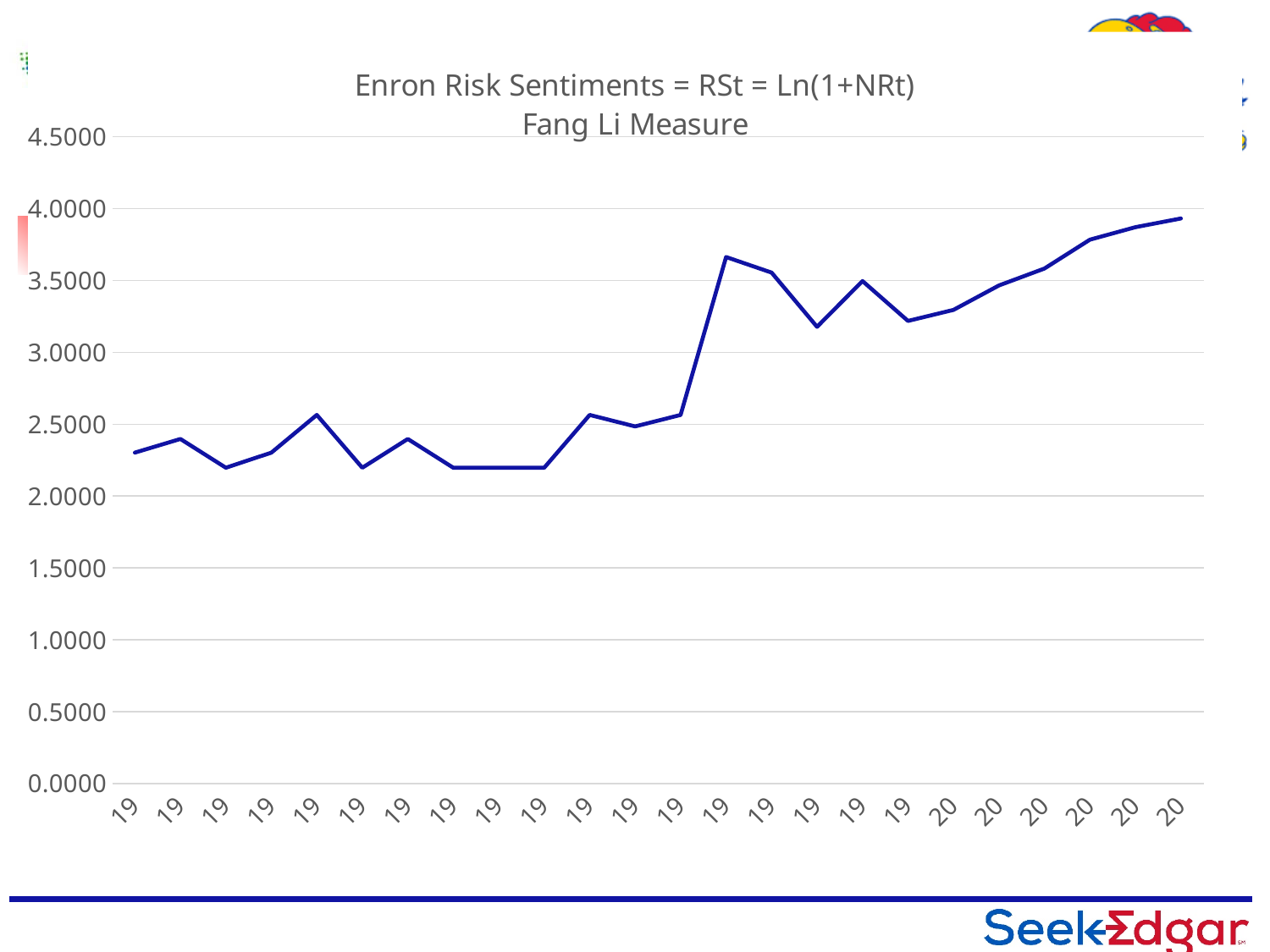
Is the value of the first (leftmost) point greater or less than 2.5000? less Is the value of the last (rightmost) point greater or less than 3.5000? greater What is the title of the chart? Enron Risk Sentiments = RSt = Ln(1+NRt) Fang Li Measure What kind of chart is shown on the slide? line chart How many data points are plotted on the line? 24 Is the lowest point on the line greater or less than 2.0000? greater Which point on the line has the highest value? the last (rightmost) point What is the highest value shown on the y axis? 4.5000 Overall, do the values rise or fall from left to right along the x axis? rise Which is larger, the value of the first point or the value of the last point? the last point